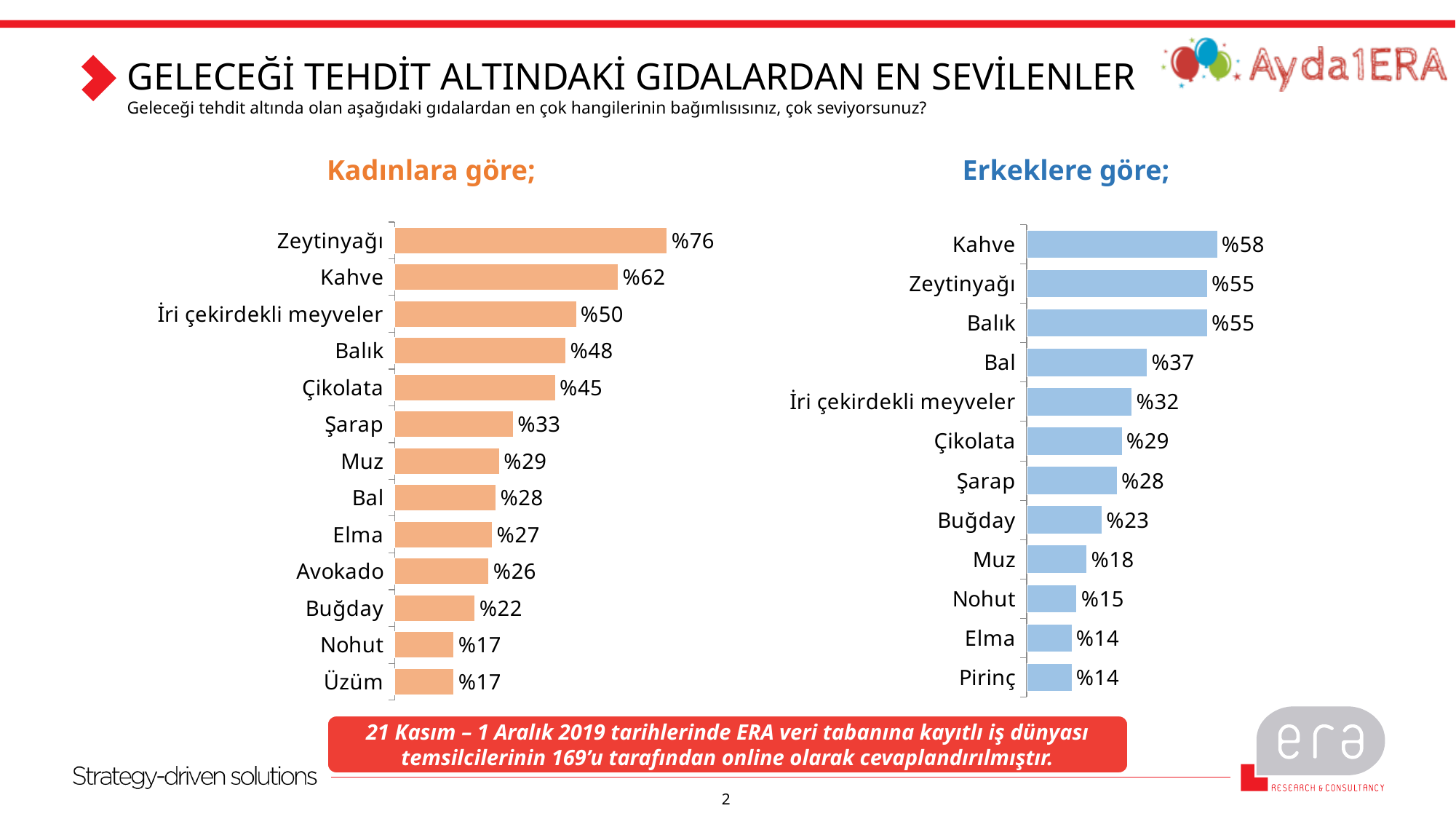
What kind of chart is the 'Erkeklere göre;' chart? Bar chart In the 'Erkeklere göre;' chart, which is larger, the value for Buğday or the value for Muz? Buğday In the 'Erkeklere göre;' chart, what is the value for Bal? %37 In the 'Kadınlara göre;' chart, which is larger, the value for Çikolata or the value for Şarap? Çikolata In the 'Erkeklere göre;' chart, which category has the highest value? Kahve How many categories are shown in the 'Erkeklere göre;' chart? 12 In the 'Kadınlara göre;' chart, what is the difference between the values for Kahve and Balık? %14 In the 'Erkeklere göre;' chart, what is the difference between the values for Kahve and Zeytinyağı? %3 In the 'Kadınlara göre;' chart, which category has the highest value? Zeytinyağı What colour are the bars in the 'Kadınlara göre;' chart? Orange In the 'Kadınlara göre;' chart, what is the value for Zeytinyağı? %76 How many categories are shown in the 'Kadınlara göre;' chart? 13